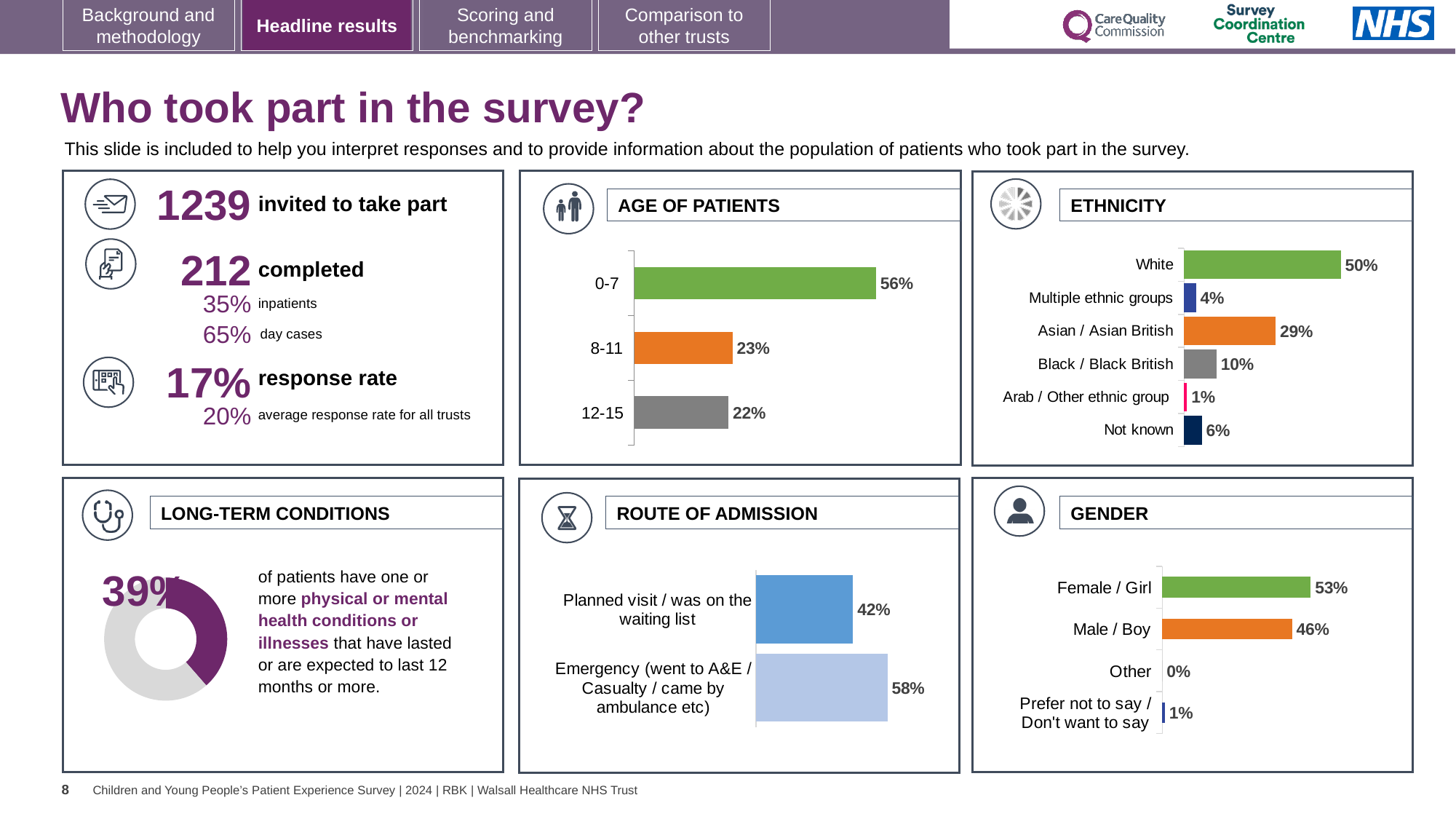
In the AGE OF PATIENTS chart, what percentage of patients are aged 0-7? 56% In the ETHNICITY chart, what percentage of patients are Asian / Asian British? 29% In the ETHNICITY chart, what is the difference between the White and Black / Black British percentages? 40% In the ROUTE OF ADMISSION chart, what percentage of patients came via Emergency (went to A&E / Casualty / came by ambulance etc)? 58% In the AGE OF PATIENTS chart, how many age groups are shown? 3 In the ETHNICITY chart, how many ethnicity categories are listed? 6 In the GENDER chart, what is the difference between the Female / Girl and Male / Boy percentages? 7% In the ROUTE OF ADMISSION chart, which route has the larger percentage: Planned visit / was on the waiting list or Emergency? Emergency (went to A&E / Casualty / came by ambulance etc) In the GENDER chart, what percentage of patients are Male / Boy? 46% What kind of chart is used in the LONG-TERM CONDITIONS panel? Donut (pie) chart In the ETHNICITY chart, which category has the highest percentage? White In the AGE OF PATIENTS chart, which age group has the lowest percentage? 12-15